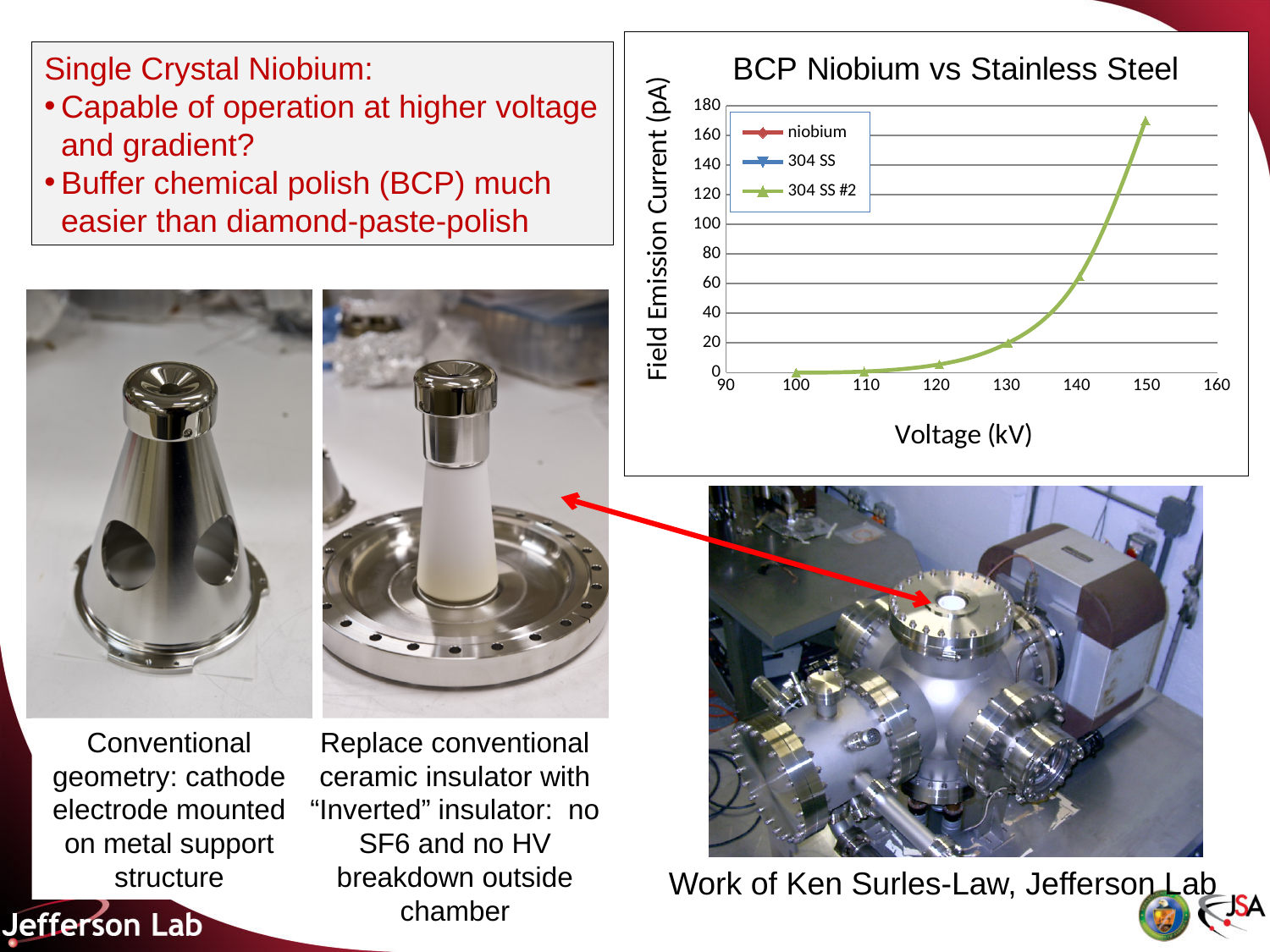
At which voltage does the 304 SS #2 series reach its highest field emission current? 150 How many series does the chart's legend list? 3 Is the field emission current for 304 SS #2 at 120 kV greater or less than 20? less Is the field emission current for 304 SS #2 at 140 kV greater or less than 80? less How many data points are plotted on the 304 SS #2 line? 6 What is the title of the chart on the slide? BCP Niobium vs Stainless Steel Does the field emission current for 304 SS #2 rise or fall as voltage increases? rise Which is larger for 304 SS #2: the field emission current at 150 kV or at 130 kV? 150 kV What kind of chart is shown on the slide? line chart What is the label of the chart's x axis? Voltage (kV) Is the field emission current for 304 SS #2 at 140 kV greater or less than 40? greater